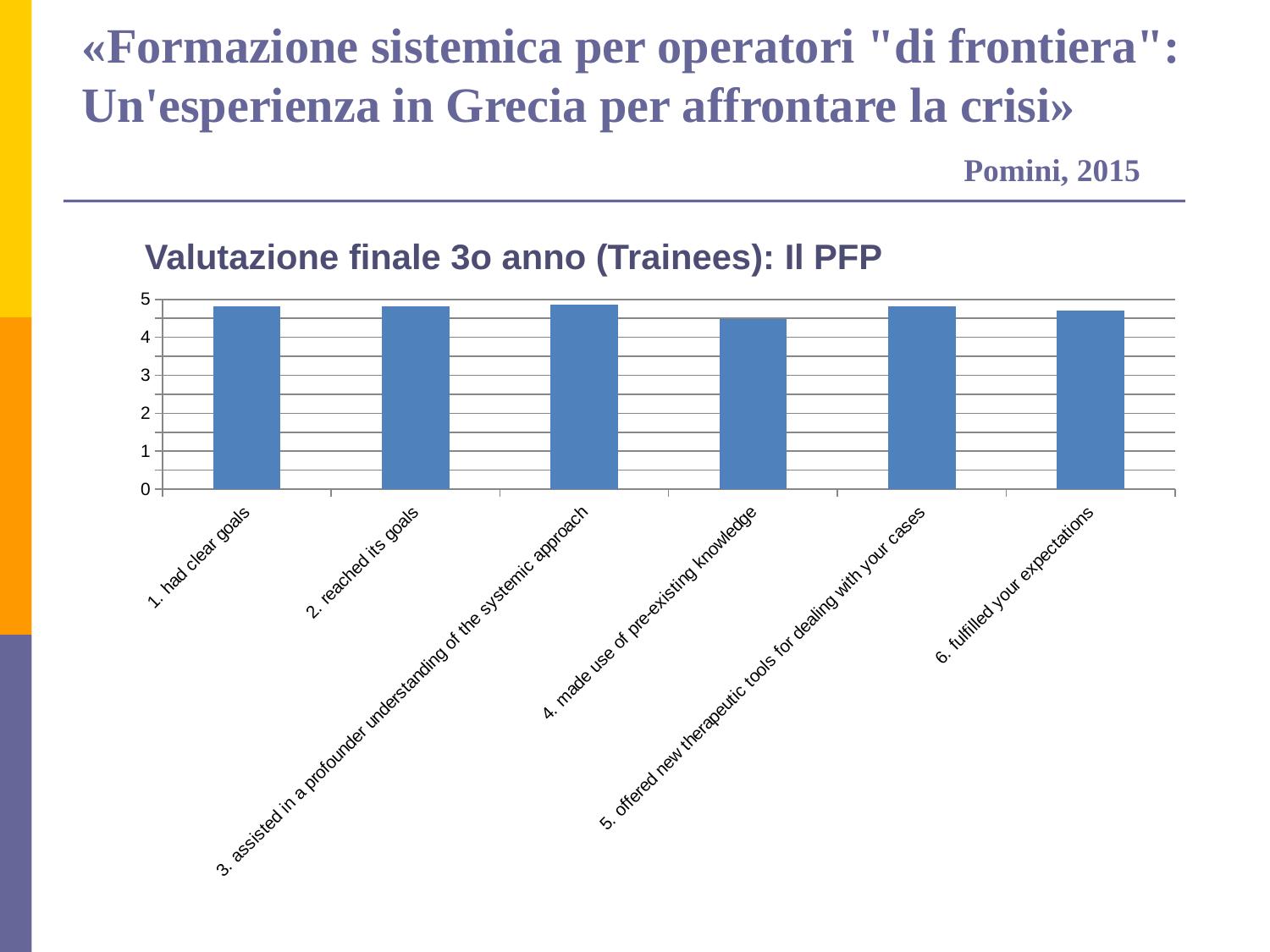
What is the maximum value shown on the vertical axis of the chart? 5 Is the value for "6. fulfilled your expectations" greater or less than 4? greater Is the value for "1. had clear goals" greater or less than 5? less Is the value for "3. assisted in a profounder understanding of the systemic approach" greater or less than 3? greater What kind of chart is shown on the slide? bar chart Which category has the lowest value in the chart? 4. made use of pre-existing knowledge Which is larger, the value for "4. made use of pre-existing knowledge" or the value for "5. offered new therapeutic tools for dealing with your cases"? 5. offered new therapeutic tools for dealing with your cases How many categories are plotted in the chart? 6 Which is larger, the value for "1. had clear goals" or the value for "4. made use of pre-existing knowledge"? 1. had clear goals What is the title of the chart? Valutazione finale 3o anno (Trainees): Il PFP